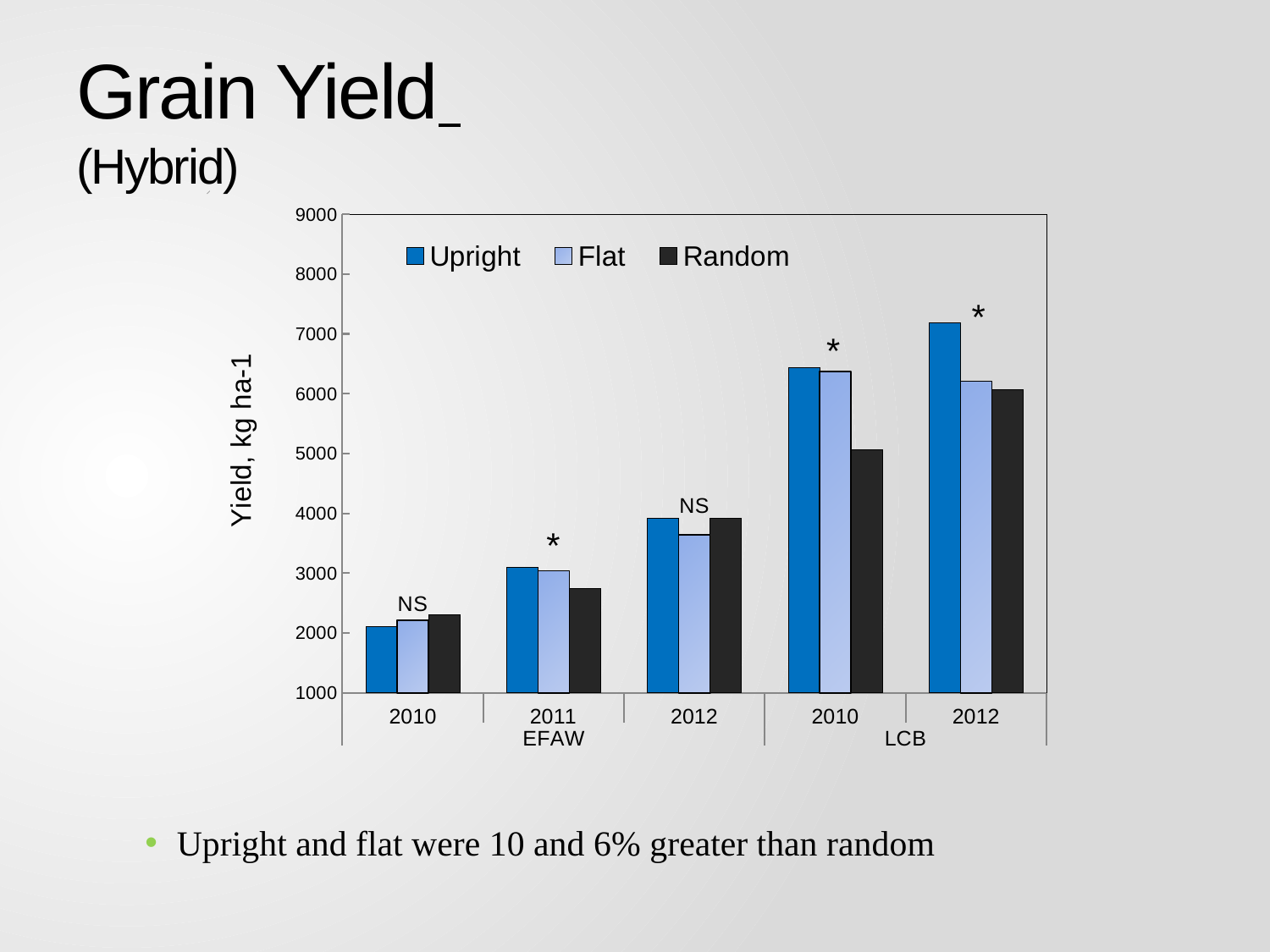
Is the Random value for 2010 at EFAW greater or less than 3000? less Which year group has the lowest Upright bar? 2010 EFAW For 2010 at LCB, which is larger, the Upright bar or the Random bar? Upright For 2012 at EFAW, which is larger, the Flat bar or the Random bar? Random How many year groups are plotted along the x axis? 5 What is the label on the y axis? Yield, kg ha-1 Which year group has the highest Upright bar? 2012 LCB Is the Random value for 2010 at LCB greater or less than 6000? less What kind of chart is shown on the slide? bar chart How many series does the legend list? 3 Is the Upright value for 2012 at LCB greater or less than 7000? greater